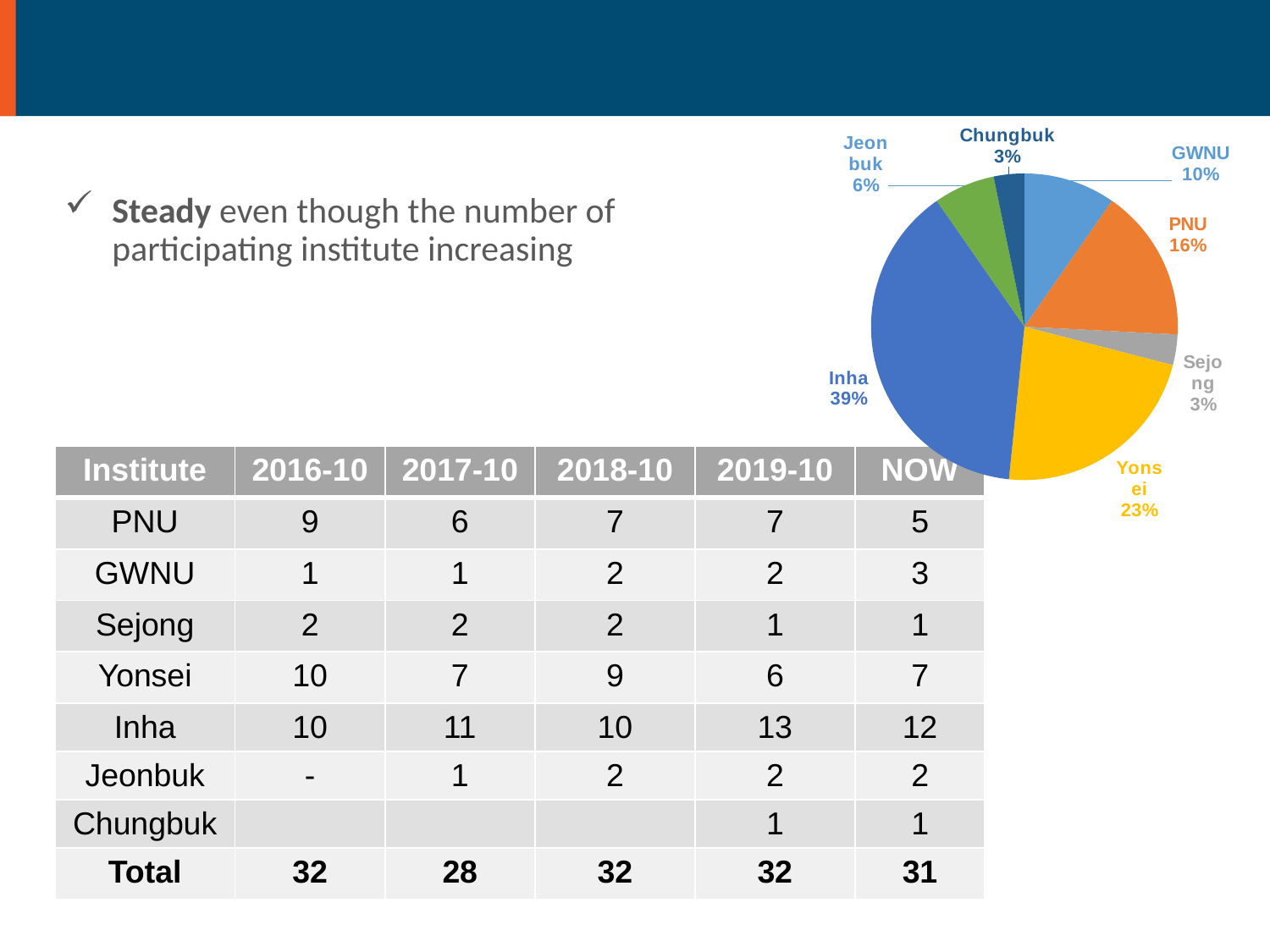
What kind of chart is shown on the slide? pie chart What share of the pie chart does PNU have? 16% What colour is the Inha slice in the pie chart? blue What share of the pie chart does GWNU have? 10% What share of the pie chart does Yonsei have? 23% What is the difference between the shares of Inha and Yonsei in the pie chart? 16% What share of the pie chart does Jeonbuk have? 6% How many slices does the pie chart have? 7 In the pie chart, which is larger, the share for PNU or the share for GWNU? PNU What is the combined share of Sejong and Chungbuk in the pie chart? 6% What share of the pie chart does Inha have? 39% Which institute has the largest slice in the pie chart? Inha